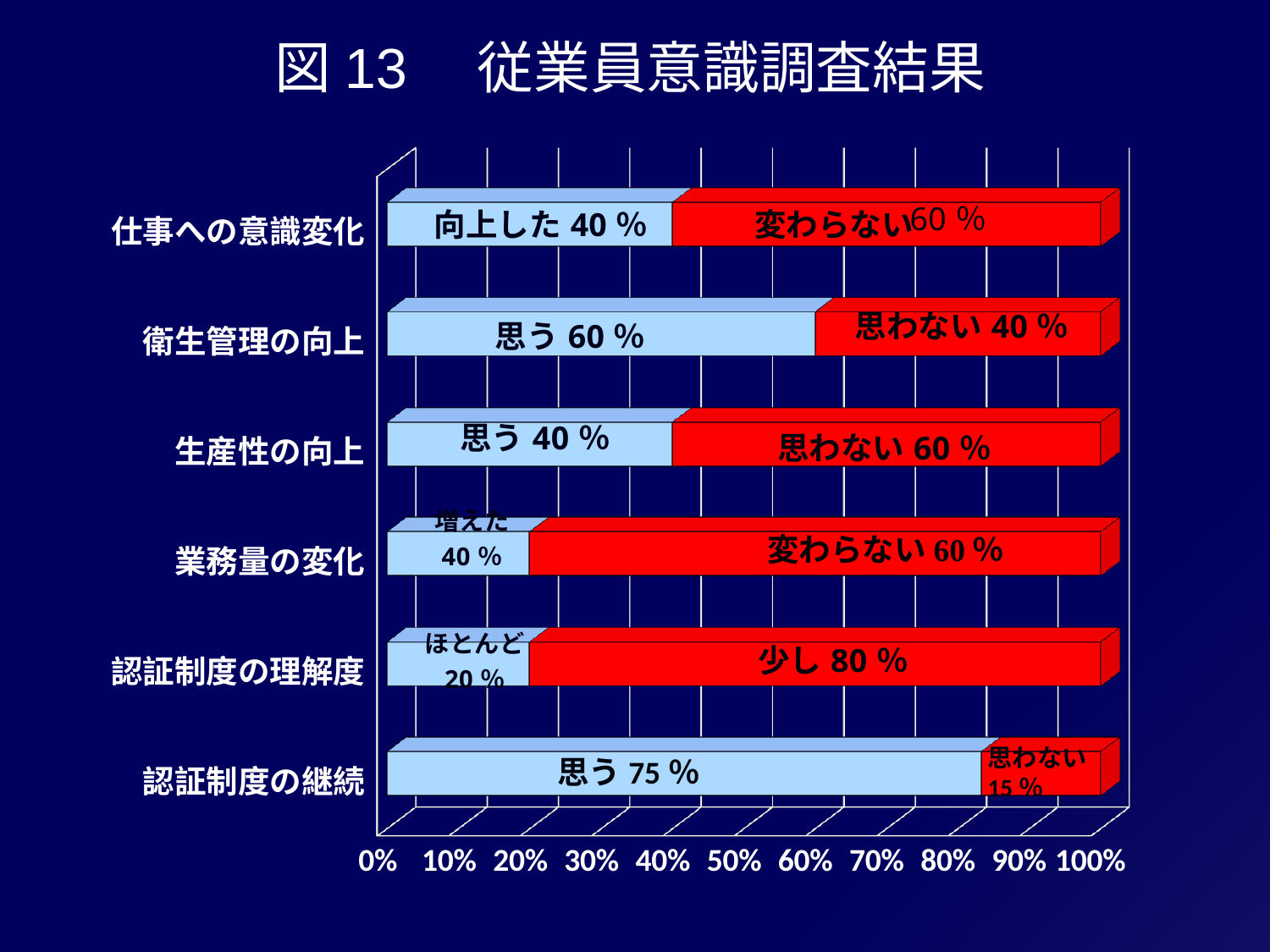
What percentage answered 少し for 認証制度の理解度? 80 % What percentage answered 向上した for 仕事への意識変化? 40 % What is the difference between 少し and ほとんど for 認証制度の理解度? 60 % What percentage answered 思わない for 認証制度の継続? 15 % Which category has the largest light-blue (first) segment? 認証制度の継続 What is the title of the chart on the slide? 図 13 従業員意識調査結果 What percentage answered 思わない for 生産性の向上? 60 % How many categories are shown on the chart? 6 What percentage answered 思う for 認証制度の継続? 75 % What kind of chart is shown on the slide? Stacked bar chart What percentage answered 思う for 衛生管理の向上? 60 %